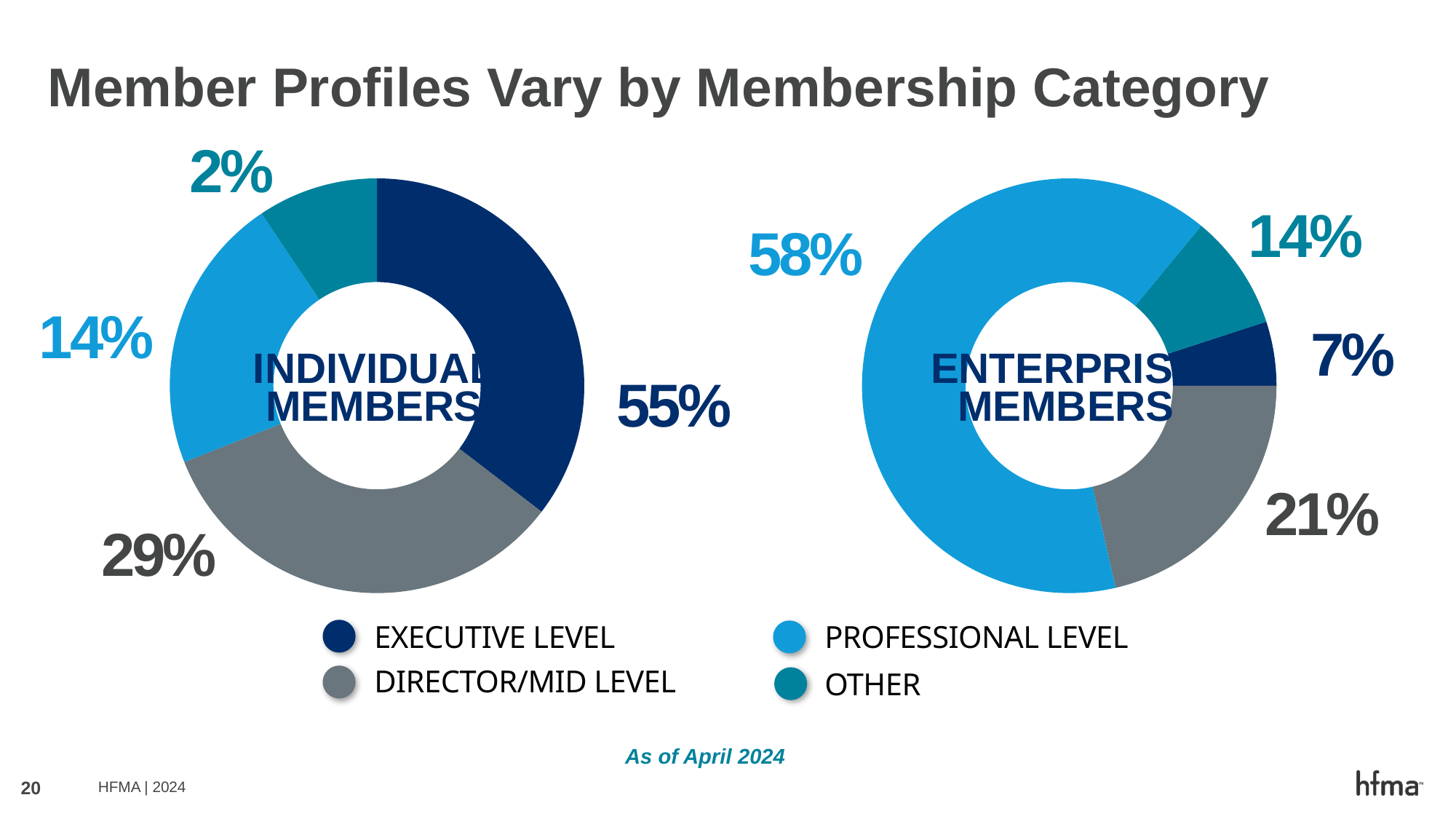
What type of chart is used for the Enterprise Members data? Pie (donut) chart In the Individual Members chart, which category has the largest share? Executive Level In the Enterprise Members chart, what share of members are Professional Level? 58% In the Enterprise Members chart, what share of members are Director/Mid Level? 21% In the Enterprise Members chart, which category has the smallest share? Executive Level Which chart has the larger Professional Level share, Individual Members or Enterprise Members? Enterprise Members In the Individual Members chart, what is the difference between the Executive Level share and the Director/Mid Level share? 26 percentage points How many categories does the legend list? 4 In the Individual Members chart, what share of members are Executive Level? 55% In the Enterprise Members chart, what share of members are Executive Level? 7% In the Individual Members chart, what share of members fall under Other? 2% In the Individual Members chart, what share of members are Director/Mid Level? 29%